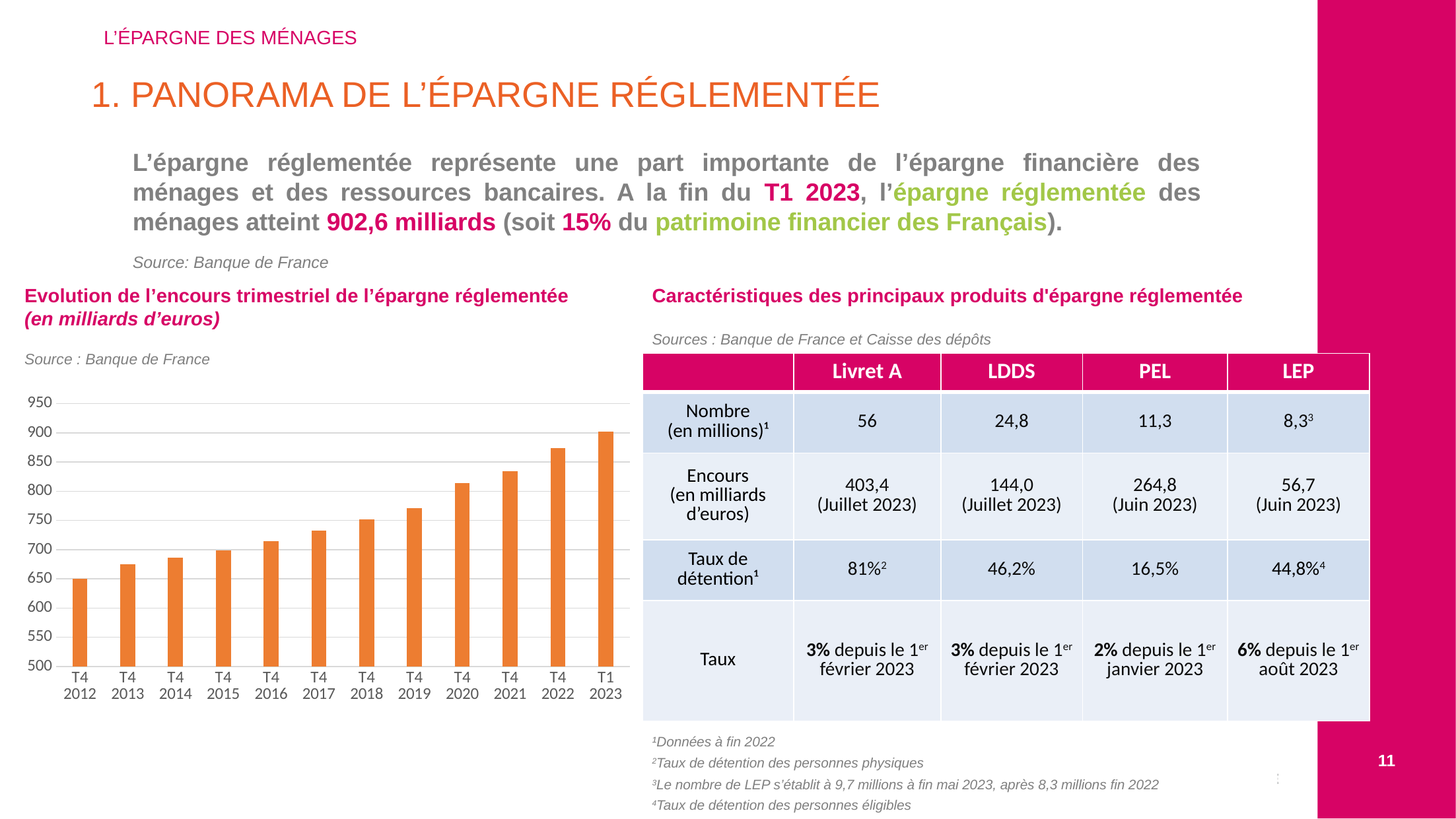
Which quarter has the lowest value in the chart 'Evolution de l'encours trimestriel de l'épargne réglementée'? T4 2012 What unit is given in the title of the bar chart? en milliards d'euros In the bar chart, do the values rise or fall from T4 2012 to T1 2023? rise In the bar chart, is the value for T4 2019 greater or less than 800? less What source is cited below the bar chart's title? Banque de France In the bar chart, is the value for T4 2021 greater or less than 800? greater In the bar chart, which is larger, the value for T4 2020 or the value for T4 2017? T4 2020 How many bars (quarters) are plotted in the chart 'Evolution de l'encours trimestriel de l'épargne réglementée'? 12 Which quarter has the highest value in the chart 'Evolution de l'encours trimestriel de l'épargne réglementée'? T1 2023 In the bar chart, is the value for T4 2012 greater or less than 700? less What kind of chart is shown on the left of the slide? bar chart